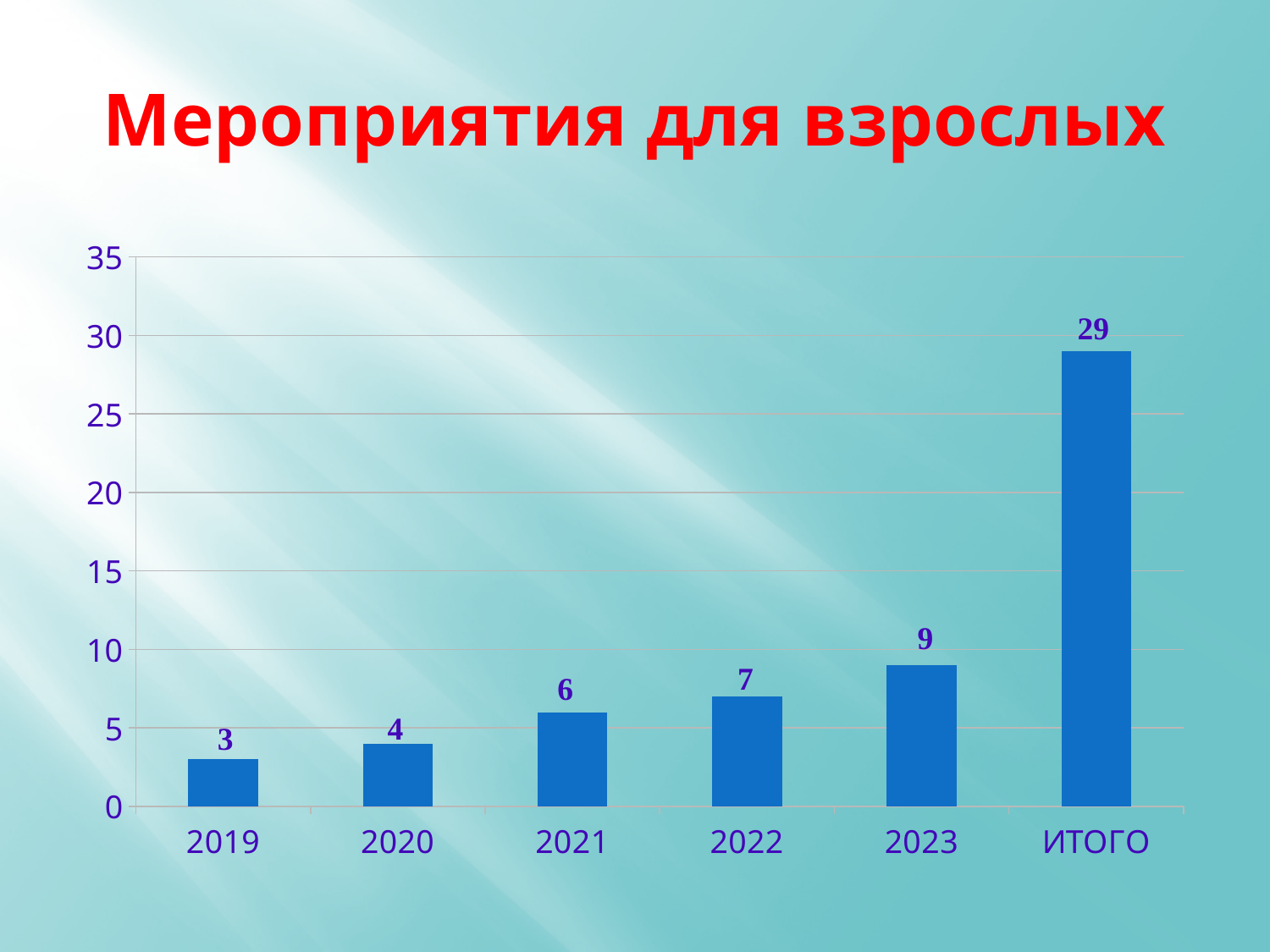
Which category has the highest value? ИТОГО What is the value for ИТОГО? 29 Do the values rise or fall from 2019 to 2023? rise What is the value for 2021? 6 What is the value for 2019? 3 Which category has the lowest value? 2019 What kind of chart is shown on the slide? bar chart What is the difference between the values for 2023 and 2020? 5 What is the value for 2023? 9 Which is larger, the value for 2022 or the value for 2021? 2022 Is the value for ИТОГО greater or less than 25? greater How many categories are shown on the x axis? 6